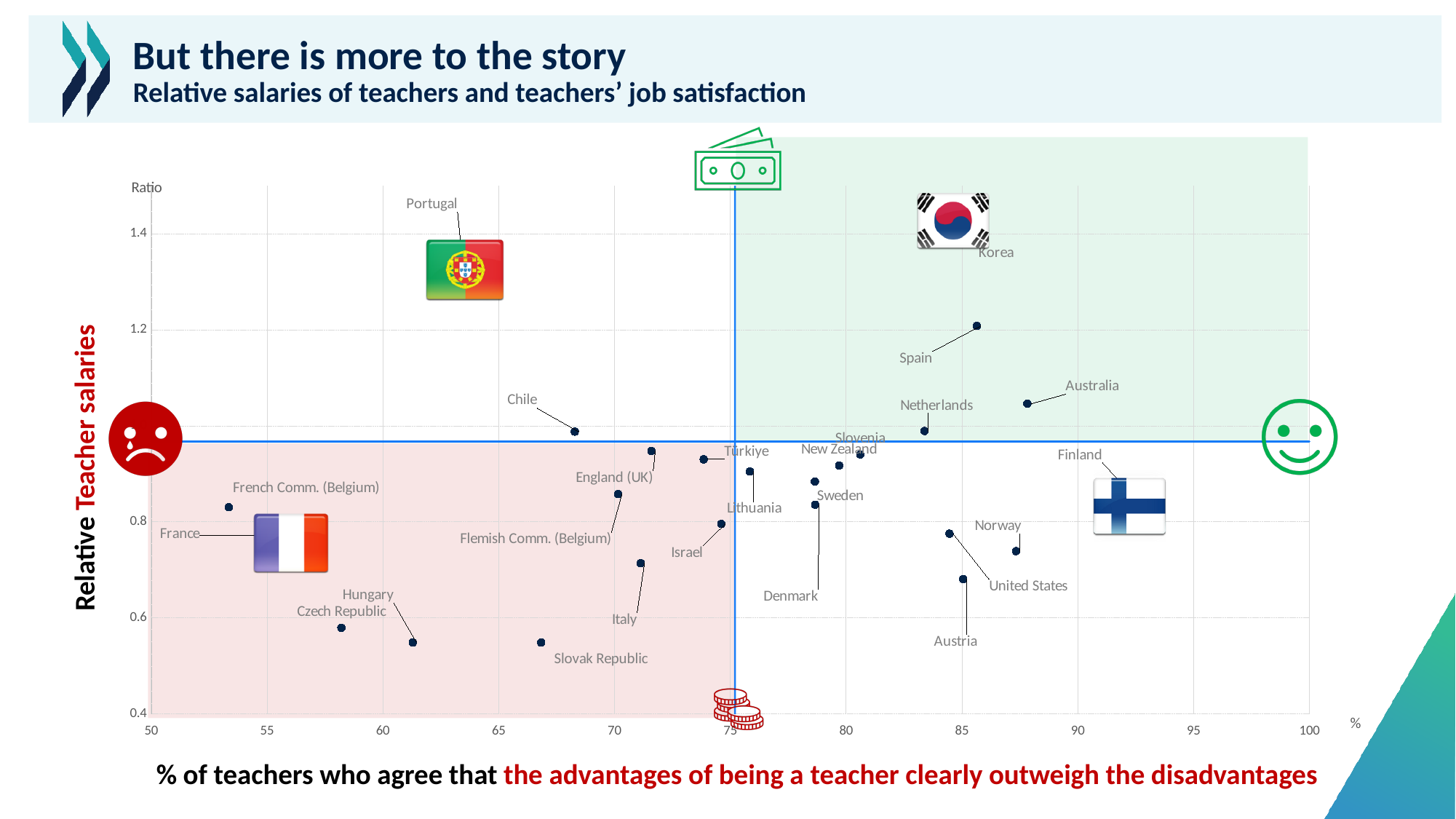
Which has a higher percentage of teachers agreeing, Norway or the Czech Republic? Norway Which has a higher relative teacher salary ratio, Spain or Australia? Spain Is the percentage of teachers agreeing for Chile greater or less than 70? less What is the label of the vertical axis of the chart? Relative Teacher salaries Which country has the lowest percentage of teachers agreeing that the advantages of being a teacher outweigh the disadvantages? French Comm. (Belgium) Is the relative teacher salary ratio for Austria greater or less than 0.8? less Is the percentage of teachers agreeing for Korea greater or less than 80? greater Which has a higher relative teacher salary ratio, Chile or Italy? Chile What kind of chart is shown on the slide? Scatter chart